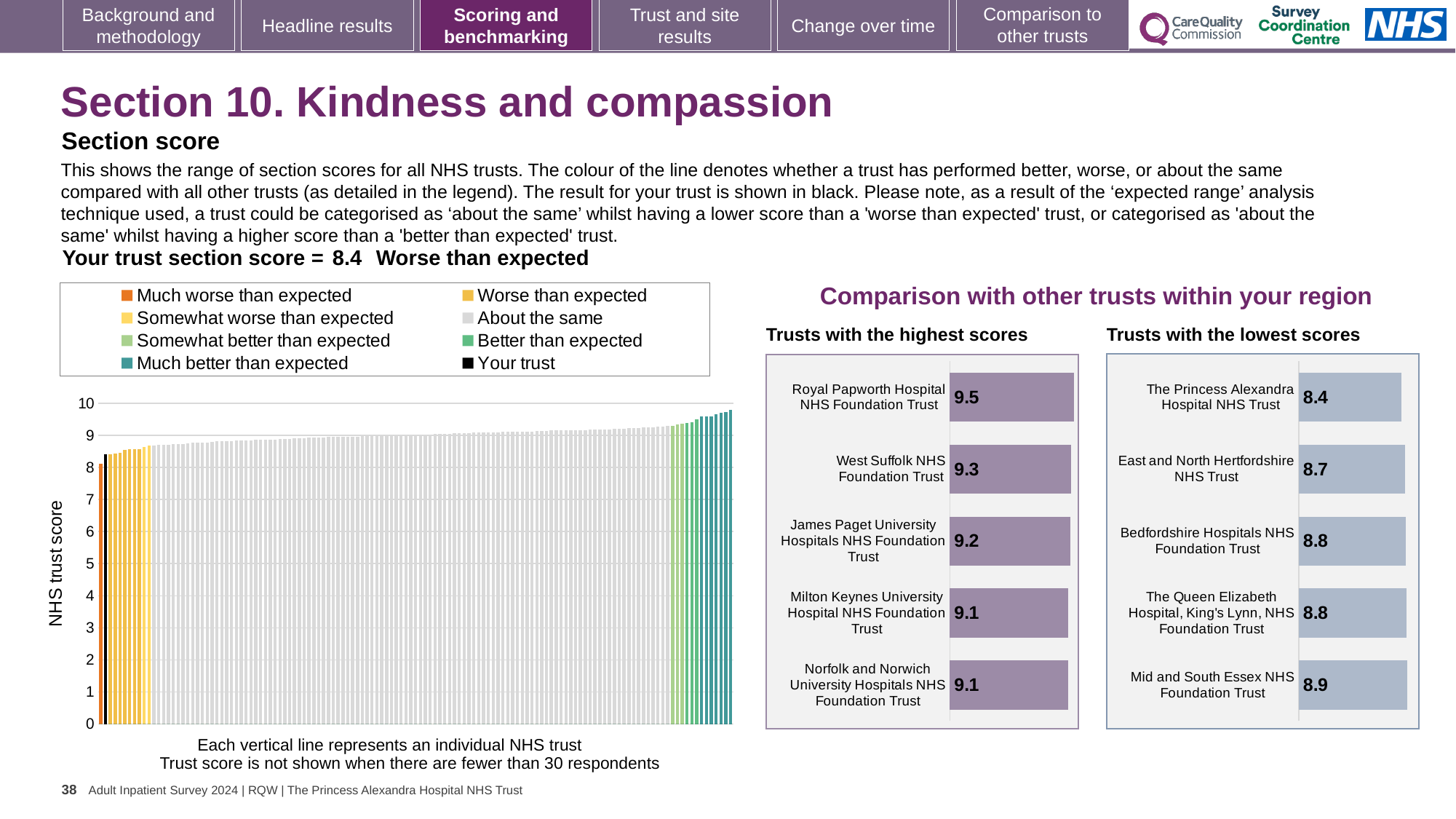
How many entries does the legend of the left-hand chart list? 8 In the 'Trusts with the lowest scores' chart, which trust has the lowest score? The Princess Alexandra Hospital NHS Trust In the 'Trusts with the highest scores' chart, which trust has the highest score? Royal Papworth Hospital NHS Foundation Trust How many trusts are shown in the 'Trusts with the lowest scores' chart? 5 In the 'Trusts with the highest scores' chart, which has the higher score: James Paget University Hospitals NHS Foundation Trust or Milton Keynes University Hospital NHS Foundation Trust? James Paget University Hospitals NHS Foundation Trust In the 'Trusts with the lowest scores' chart, what is the score for Mid and South Essex NHS Foundation Trust? 8.9 In the 'Trusts with the highest scores' chart, what is the difference between the scores of Royal Papworth Hospital NHS Foundation Trust and West Suffolk NHS Foundation Trust? 0.2 In the left-hand chart, is the value for the black bar representing your trust greater or less than 9? less What kind of chart is the large chart on the left showing the range of section scores for all NHS trusts? Bar chart In the 'Trusts with the lowest scores' chart, what is the score for East and North Hertfordshire NHS Trust? 8.7 In the 'Trusts with the highest scores' chart, what is the score for Royal Papworth Hospital NHS Foundation Trust? 9.5 In the 'Trusts with the lowest scores' chart, how much higher is the score of Mid and South Essex NHS Foundation Trust than that of The Princess Alexandra Hospital NHS Trust? 0.5